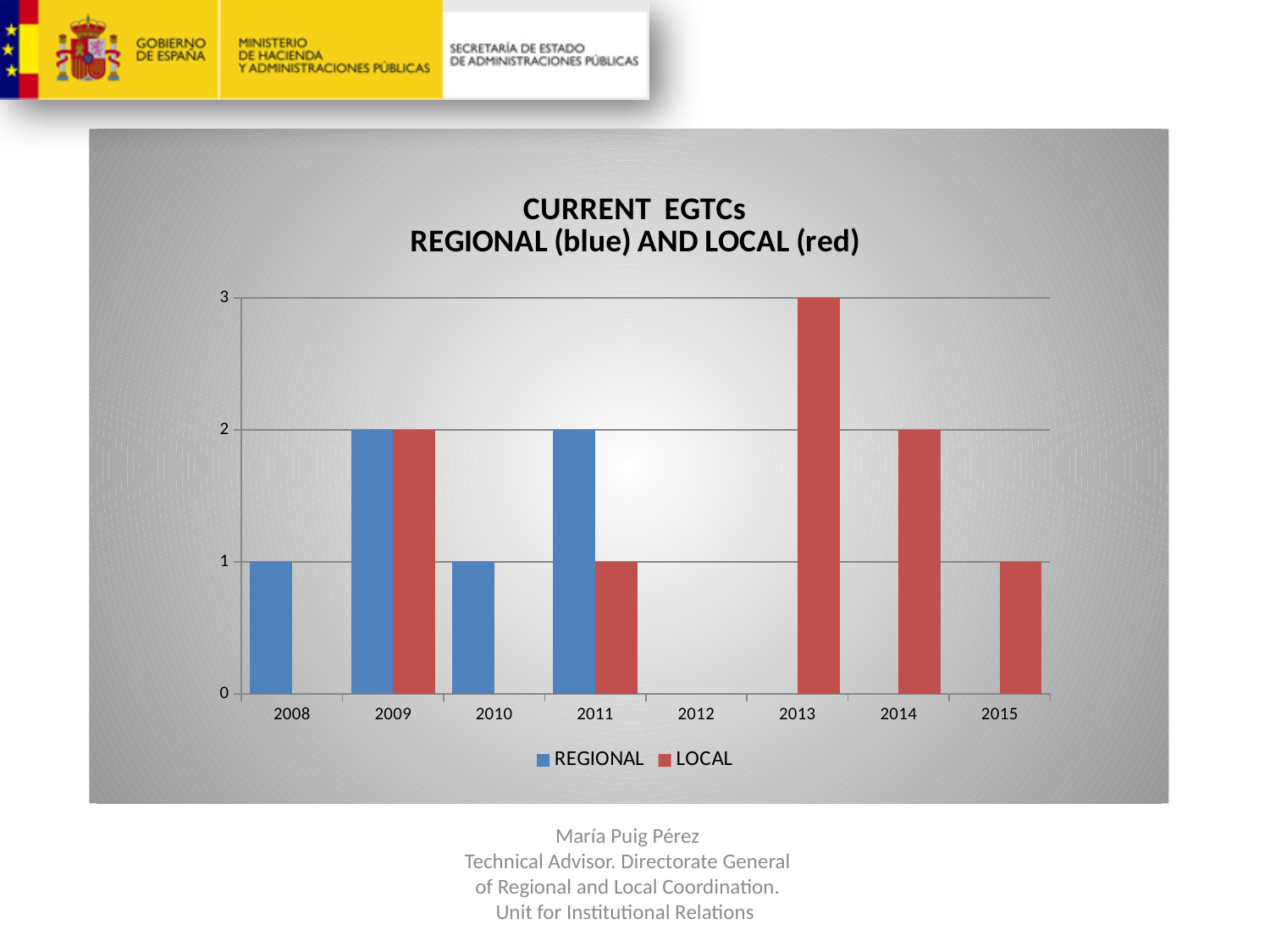
In which year is the LOCAL value highest? 2013 Which year has no bars for either series? 2012 How many years are shown on the x axis? 8 What is the title of the chart? CURRENT EGTCs REGIONAL (blue) AND LOCAL (red) What type of chart is shown on the slide? bar chart What is the LOCAL value for 2014? 2 Which is larger in 2011, the REGIONAL value or the LOCAL value? REGIONAL What is the REGIONAL value for 2010? 1 What is the LOCAL value for 2013? 3 How many series does the legend list? 2 What is the REGIONAL value for 2009? 2 What is the difference between the LOCAL value for 2013 and the LOCAL value for 2015? 2